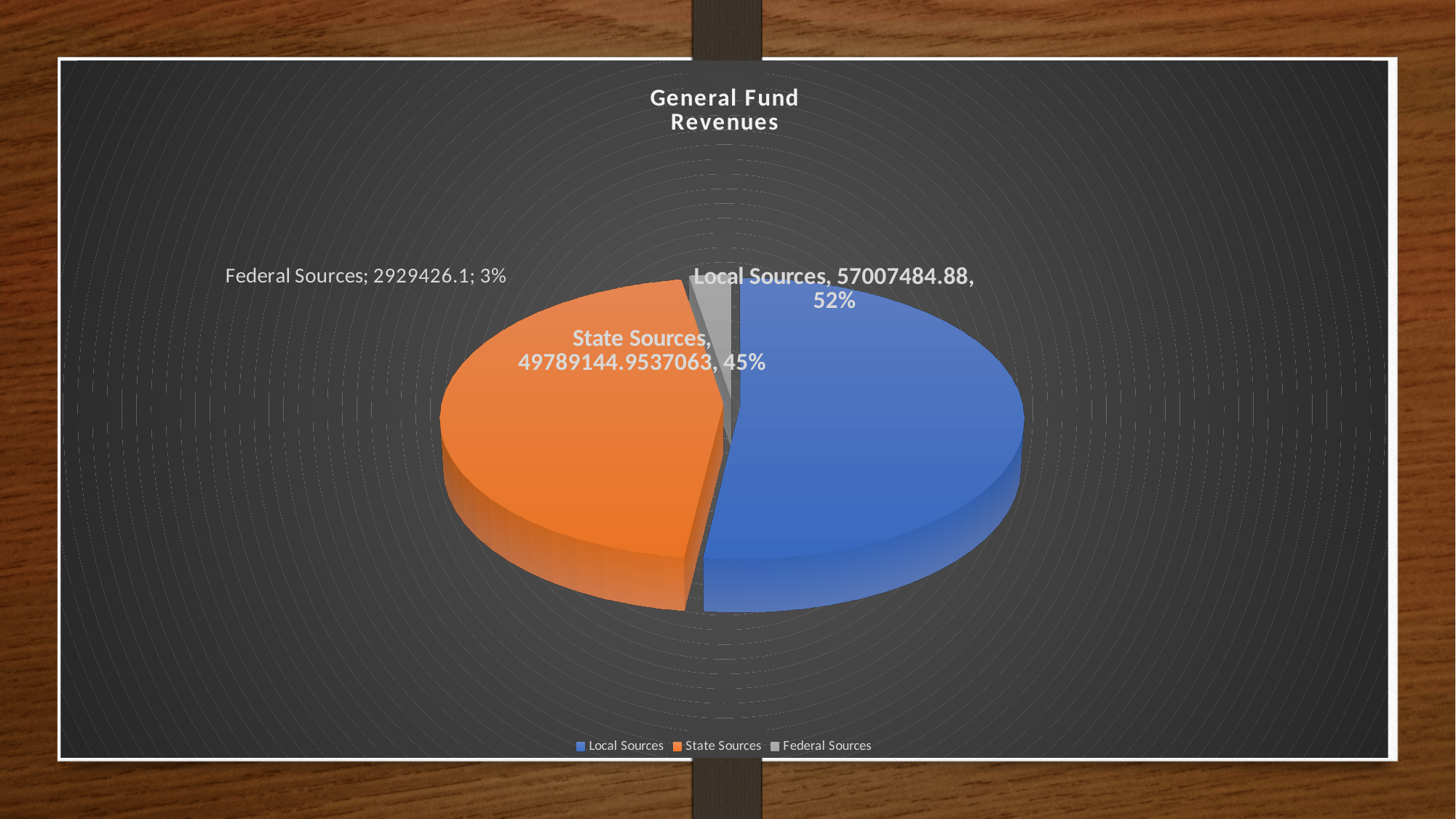
Which is larger, State Sources or Federal Sources? State Sources What is the value for Local Sources? 57007484.88 What share of the pie is Federal Sources? 3% Which source has the smallest share of General Fund Revenues? Federal Sources What is the title of the chart? General Fund Revenues How many slices does the pie chart have? 3 What share of the pie is State Sources? 45% What is the value for Federal Sources? 2929426.1 What share of the pie is Local Sources? 52% What kind of chart is shown on the slide? pie chart What is the value for State Sources? 49789144.9537063 Which source has the largest share of General Fund Revenues? Local Sources